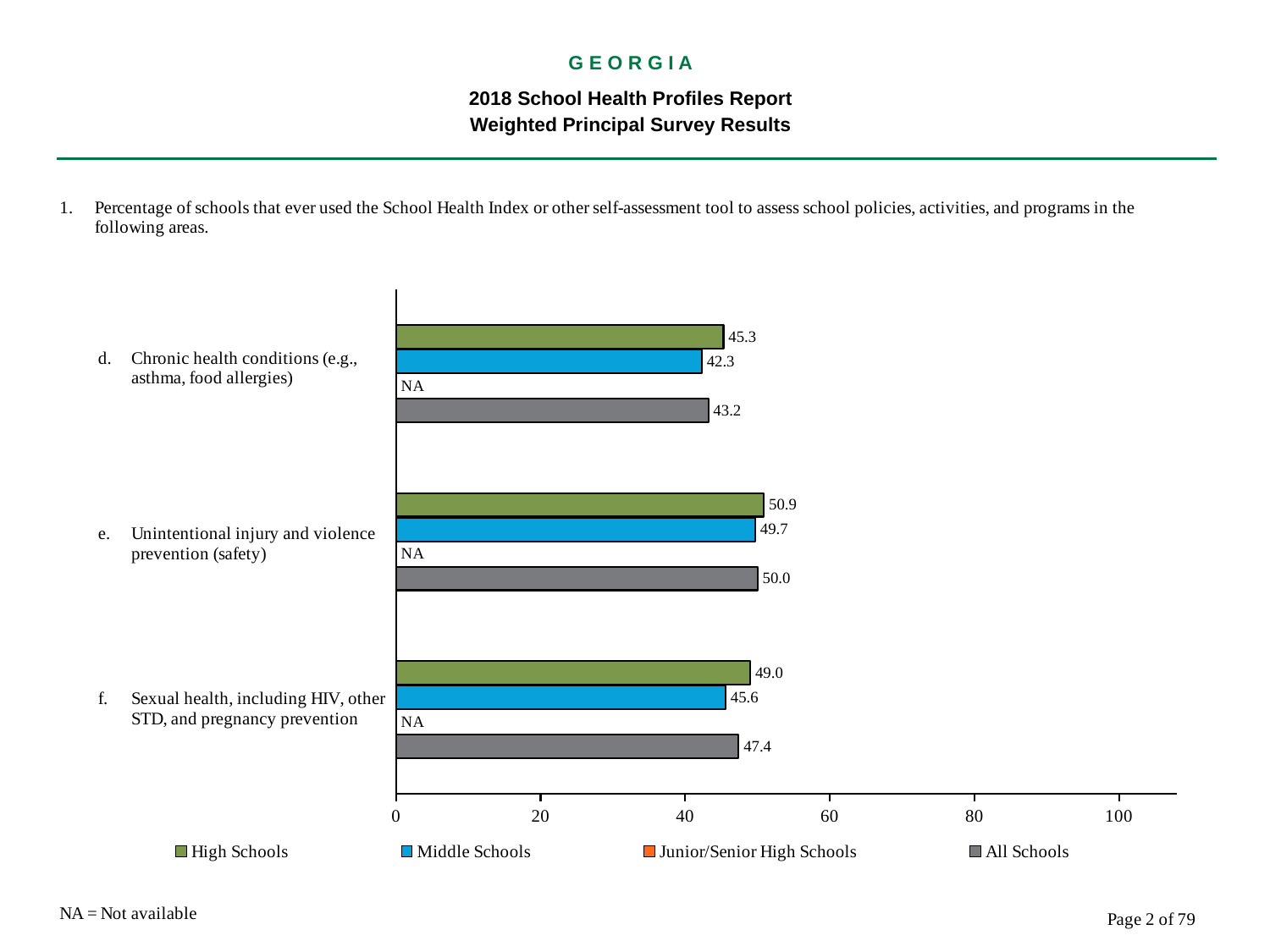
How many categories are shown on the chart? 3 Is the All Schools value for Unintentional injury and violence prevention (safety) greater or less than 40? greater Which category has the lowest value for Middle Schools? Chronic health conditions (e.g., asthma, food allergies) How many series does the legend list? 4 What kind of chart is shown on the slide? bar chart Which is larger for Chronic health conditions: the High Schools value or the All Schools value? High Schools Which category has the highest value for High Schools? Unintentional injury and violence prevention (safety) What is the value for All Schools for Sexual health, including HIV, other STD, and pregnancy prevention? 47.4 What value is shown for Junior/Senior High Schools for Chronic health conditions? NA What is the value for High Schools for Chronic health conditions (e.g., asthma, food allergies)? 45.3 What is the difference between the High Schools and Middle Schools values for Sexual health, including HIV, other STD, and pregnancy prevention? 3.4 What is the value for Middle Schools for Unintentional injury and violence prevention (safety)? 49.7